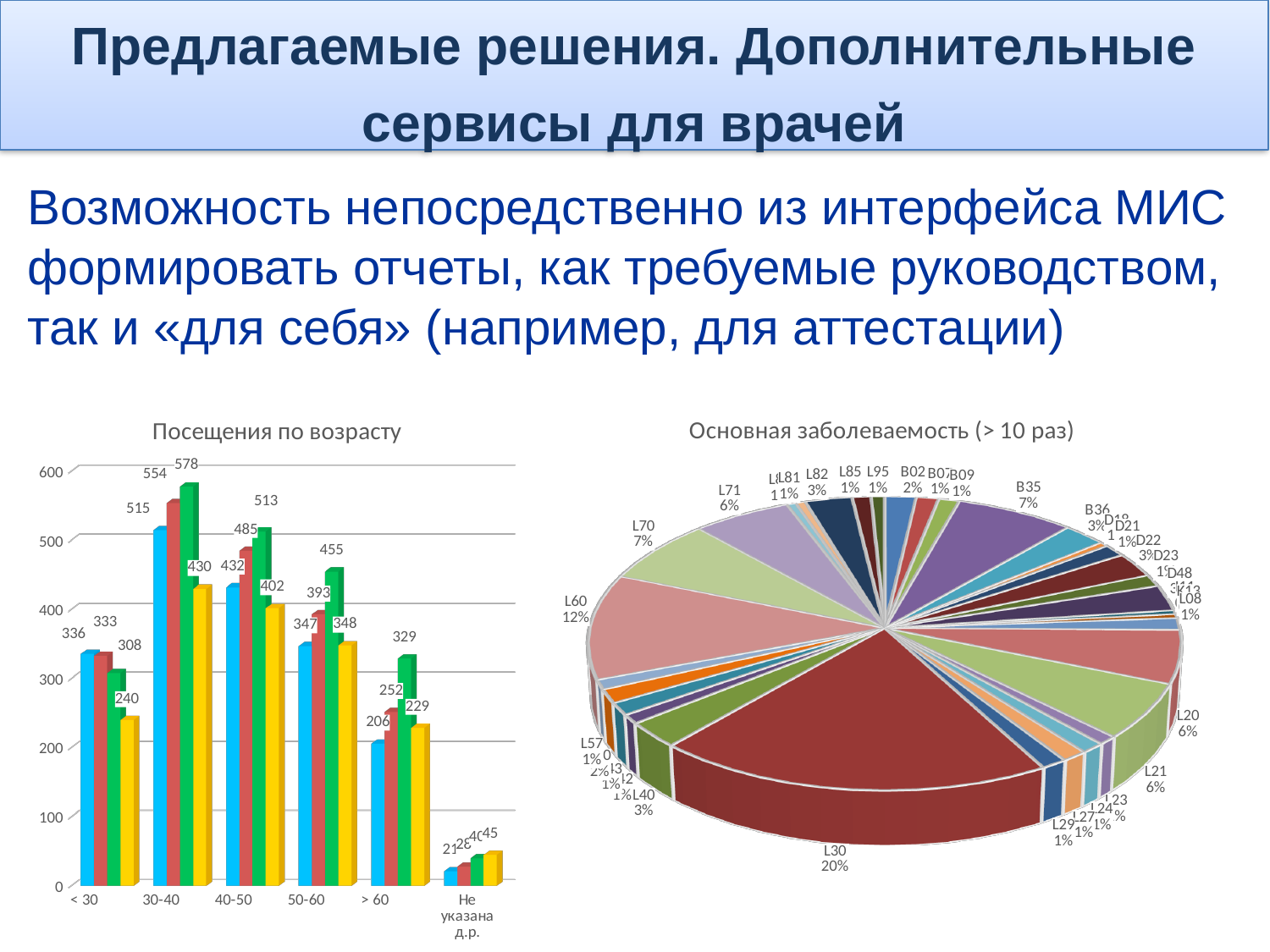
In the 'Посещения по возрасту' chart, what is the value of the blue bar for the 30-40 category? 515 In the 'Основная заболеваемость (> 10 раз)' pie chart, what share does B35 have? 7% In the 'Посещения по возрасту' chart, is the yellow bar for the > 60 category greater or less than 300? less In the 'Посещения по возрасту' chart, which is larger: the blue bar for < 30 or the blue bar for 50-60? 50-60 In the 'Посещения по возрасту' chart, what is the value of the yellow bar for the 40-50 category? 402 In the 'Посещения по возрасту' chart, what is the highest value labelled on any bar? 578 In the 'Посещения по возрасту' chart, what is the difference between the green bar (578) and the red bar (554) for the 30-40 category? 24 In the 'Основная заболеваемость (> 10 раз)' pie chart, what share does L60 have? 12% In the 'Основная заболеваемость (> 10 раз)' pie chart, which slice is the largest? L30 How many age categories are shown on the x axis of the 'Посещения по возрасту' chart? 6 What kind of chart is the 'Основная заболеваемость (> 10 раз)' chart on the right? pie chart What kind of chart is the 'Посещения по возрасту' chart on the left? bar chart